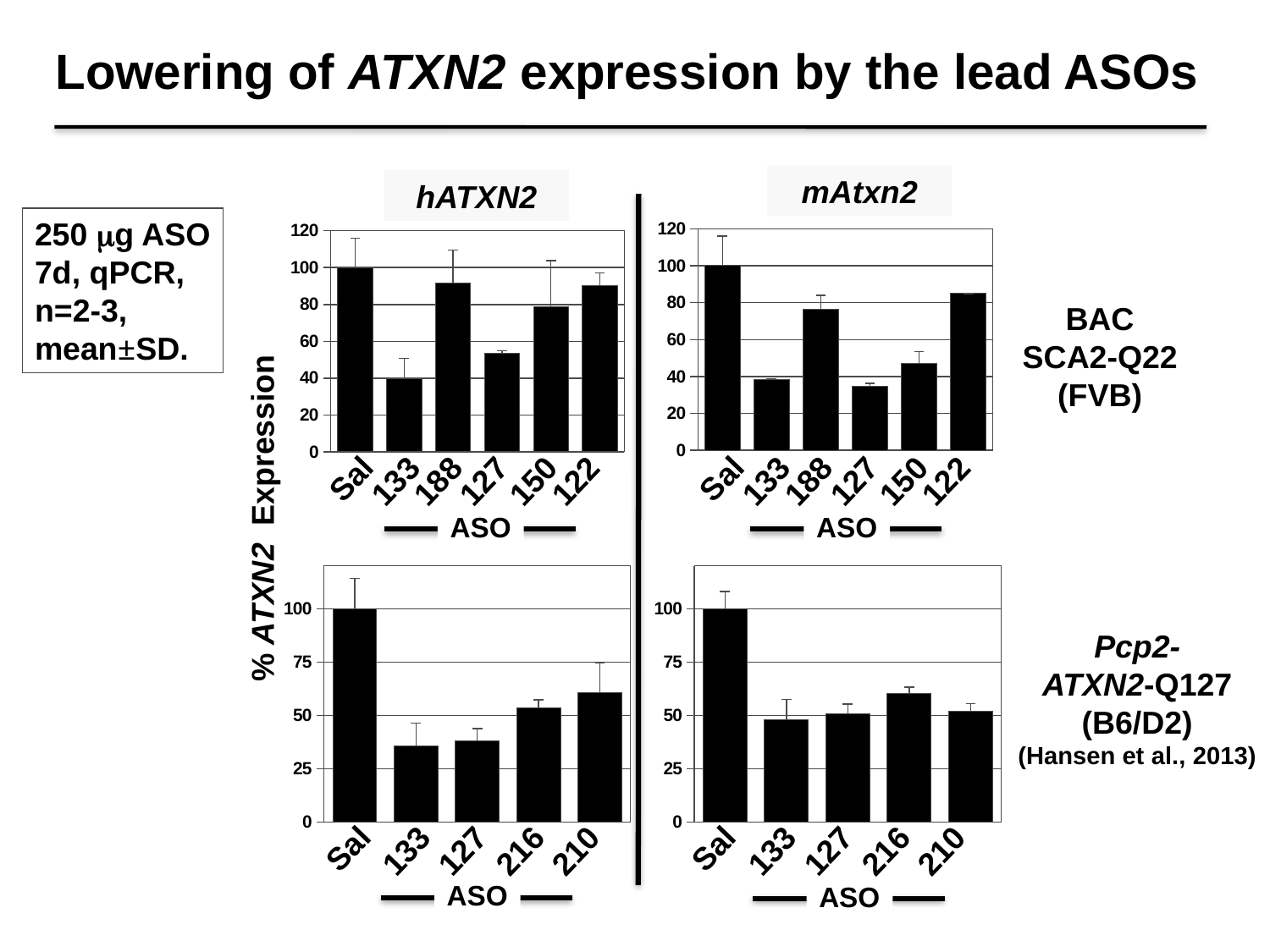
What kind of chart is the top-left hATXN2 chart? bar chart In the bottom-left hATXN2 chart, which is larger, the value for 133 or the value for 210? 210 In the top-left hATXN2 chart, is the value for 133 greater or less than 60? less In the top-left hATXN2 chart, what is the value for Sal? 100 In the bottom-left hATXN2 chart, how many bars (categories) are shown? 5 In the top-left hATXN2 chart, which is larger, the value for 188 or the value for 127? 188 What is the label on the shared y axis of the charts? % ATXN2 Expression In the top-left hATXN2 chart, which category has the lowest value? 133 In the bottom-right mAtxn2 chart, which category has the highest value? Sal In the top-left hATXN2 chart, which category has the highest value? Sal In the top-right mAtxn2 chart, is the value for 188 greater or less than 60? greater In the top-left hATXN2 chart, how many bars (categories) are shown? 6